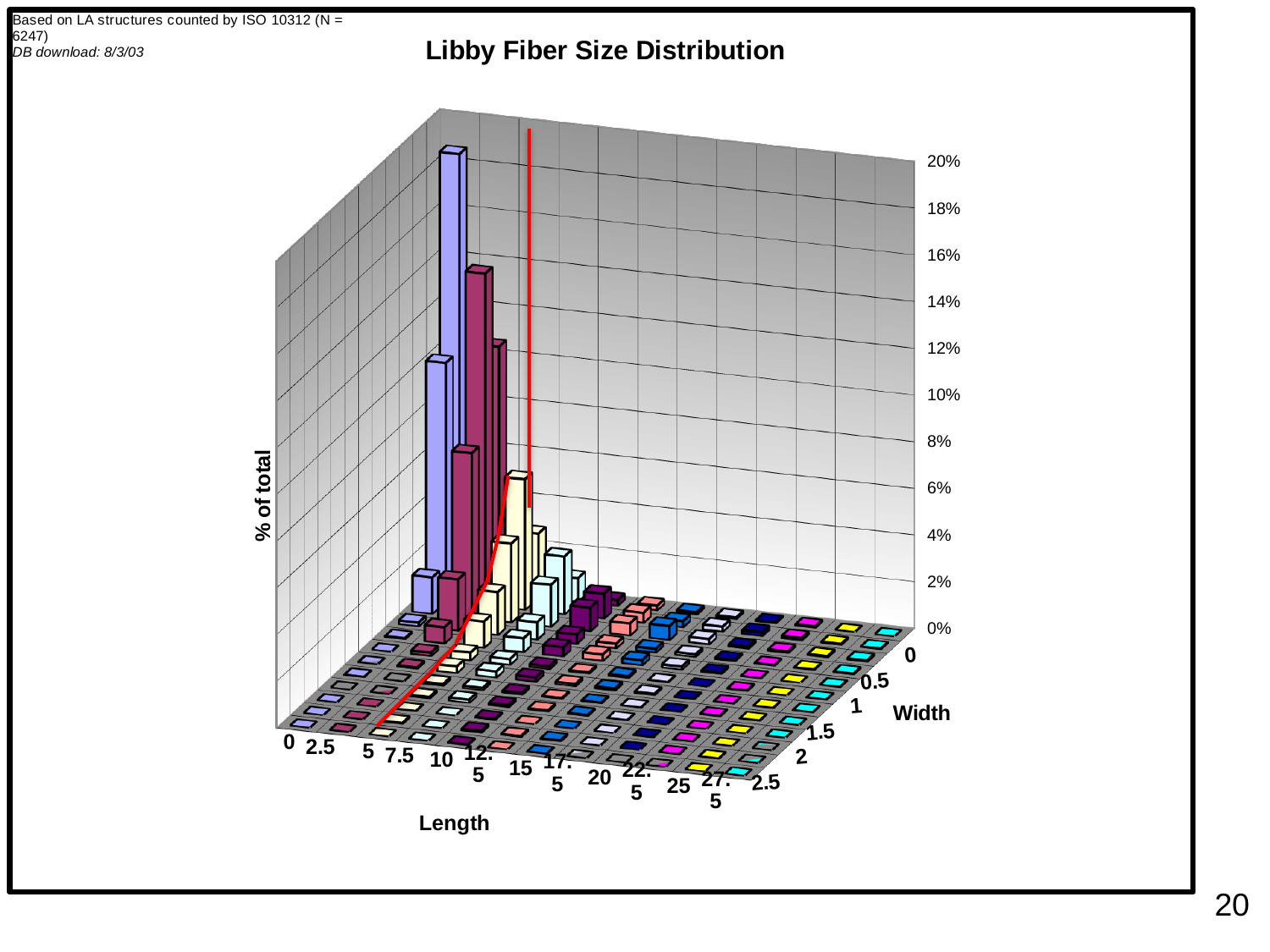
What type of chart is shown on the slide? 3D bar chart Is the tallest bar in the chart greater or less than 10%? greater Are the bars at Length 27.5 greater or less than 2%? less How many Width categories are shown along the Width axis? 6 How many Length categories are shown along the Length axis? 12 As Length increases from 0 to 27.5, do the bars generally get taller or shorter? shorter Which Length category has taller bars, 0 or 25? 0 What is the title of the chart? Libby Fiber Size Distribution Which Length category contains the tallest bar in the chart? 0 What is the label of the vertical axis of the chart? % of total